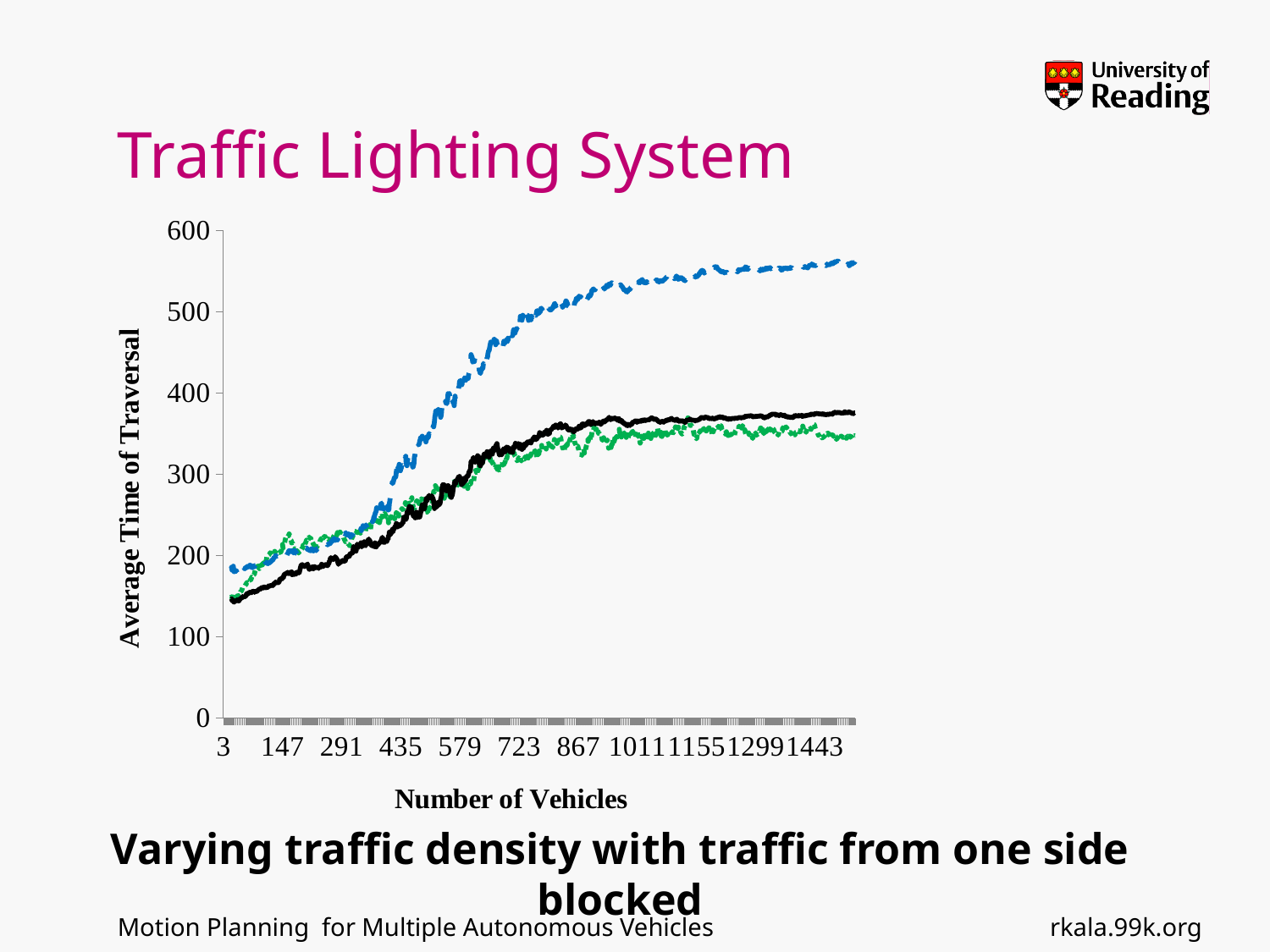
What kind of chart is shown on the slide? line chart Is the value of the black solid line at 1443 vehicles greater or less than 400? less Is the value of the blue dashed line at 1443 vehicles greater or less than 500? greater Is the value of the black solid line at 3 vehicles greater or less than 200? less At 1443 vehicles, which line has the larger value, the blue dashed line or the black solid line? blue dashed line Which line reaches the highest average time of traversal? blue dashed line What is the label of the y axis? Average Time of Traversal Which line has the lowest value at the right end of the chart (1443 vehicles)? green dotted line How many lines are plotted on the chart? 3 Do the plotted values rise or fall as the number of vehicles increases? rise